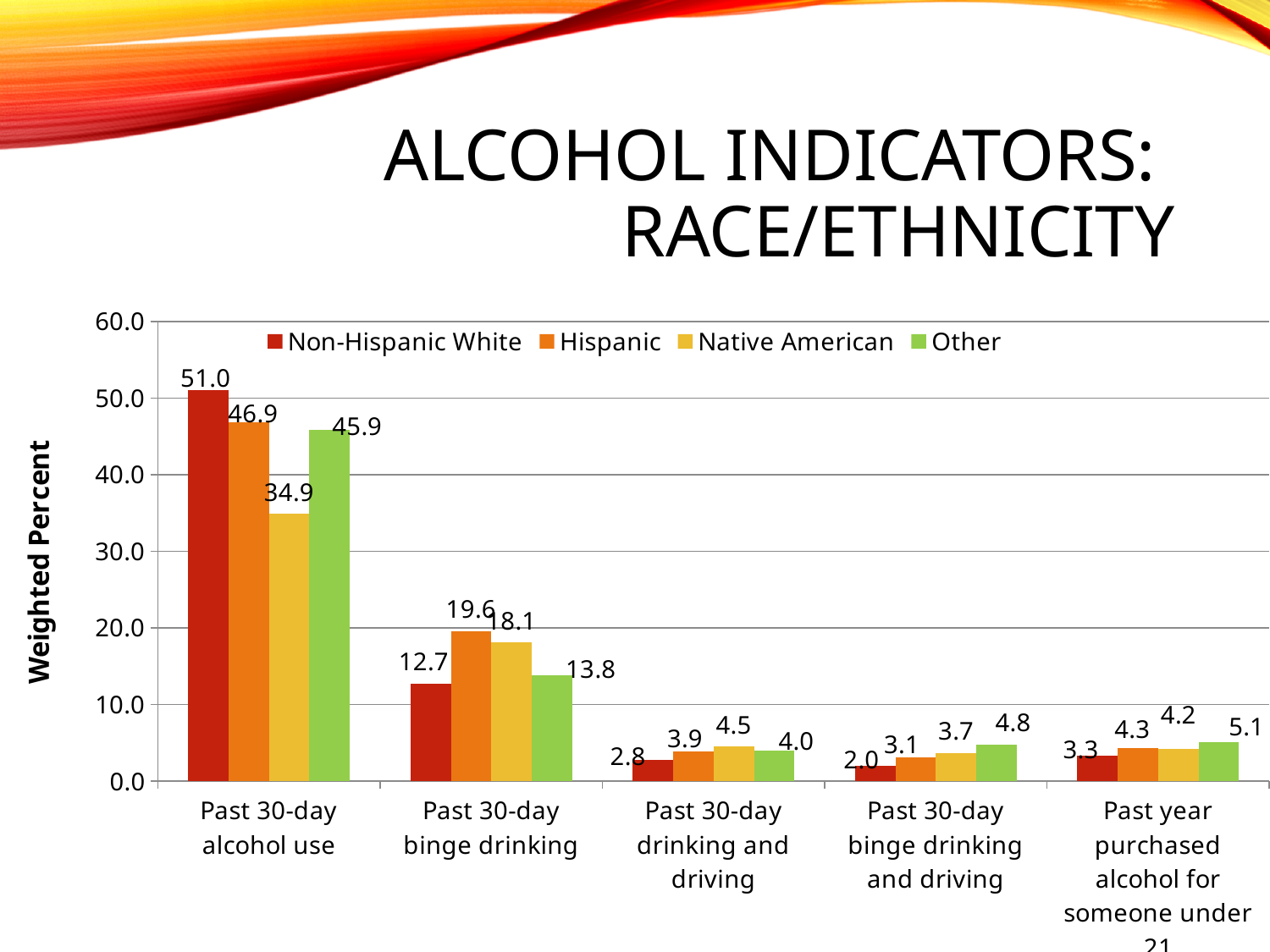
Which group has the highest value for Past 30-day binge drinking? Hispanic What is the value for Non-Hispanic White for Past 30-day alcohol use? 51.0 Is the value for Other for Past 30-day alcohol use greater or less than 40.0? greater What is the value for Other for Past 30-day drinking and driving? 4.0 What is the value for Native American for Past 30-day binge drinking? 18.1 Which is larger for Past 30-day binge drinking and driving: Native American or Other? Other How many series does the legend list? 4 What is the label of the y axis? Weighted Percent What is the difference between the Non-Hispanic White and Hispanic values for Past 30-day alcohol use? 4.1 Which group has the lowest value for Past 30-day alcohol use? Native American How many indicator categories are shown on the x axis? 5 What kind of chart is shown on the slide? bar chart